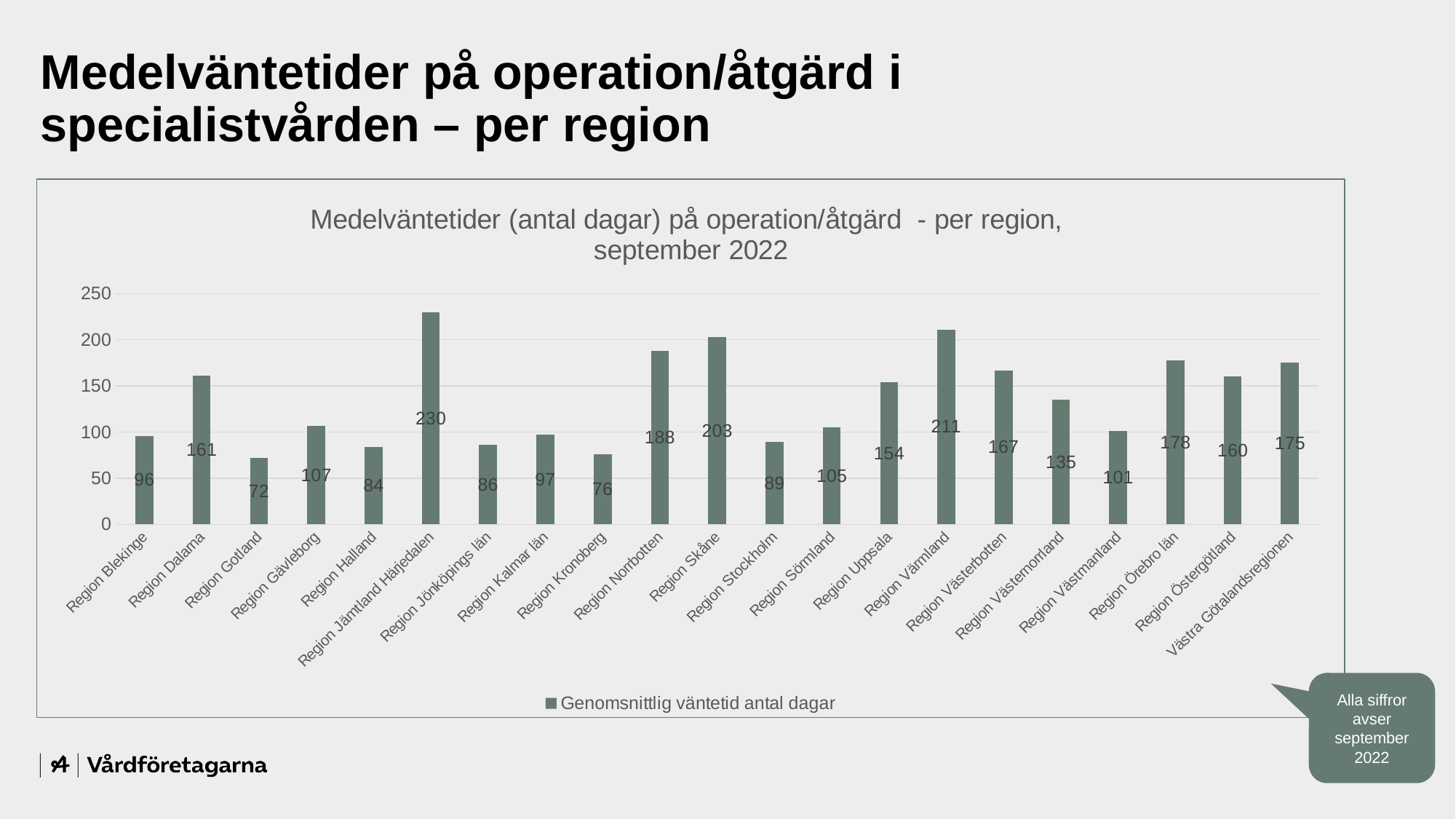
What is the value for Västra Götalandsregionen? 175 How many regions are shown on the x axis? 21 What is the difference in days between Region Värmland and Region Norrbotten? 23 Which region has the highest average waiting time? Region Jämtland Härjedalen What is the legend entry of the chart? Genomsnittlig väntetid antal dagar How many series does the legend list? 1 What value is shown for Region Stockholm? 89 Which region has the lowest average waiting time? Region Gotland What kind of chart is shown on the slide? Bar chart Which has a higher value, Region Dalarna or Region Östergötland? Region Dalarna Is the value for Region Västernorrland greater or less than 150? less What is the average waiting time in days for Region Skåne? 203